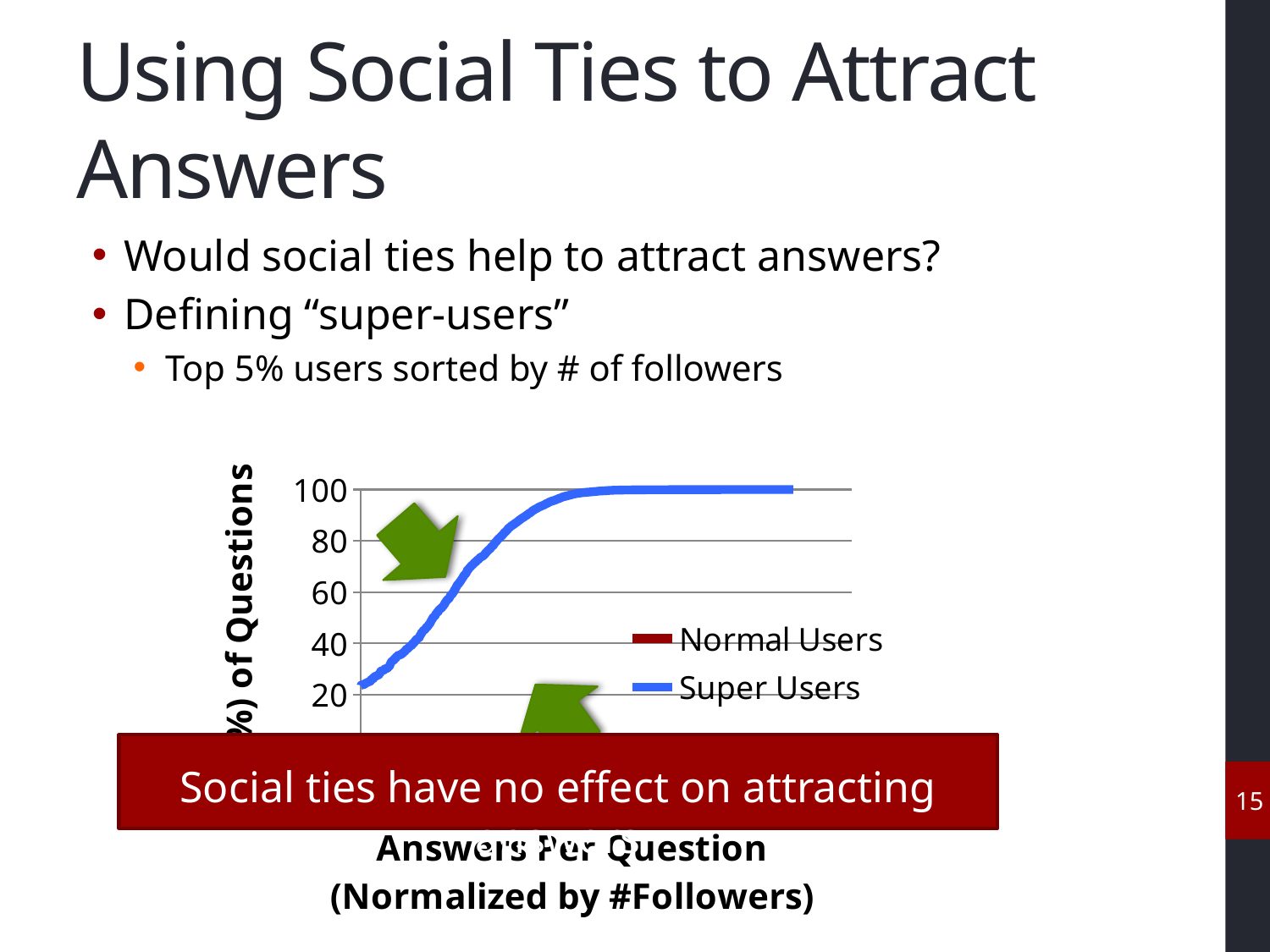
At the far right of the chart, is the Super Users line greater or less than 80? greater What is the highest tick value shown on the chart's y axis? 100 What kind of chart is shown on the slide? line chart At the far left of the chart, is the Super Users line greater or less than 40? less What is the x-axis label of the chart? Answers Per Question (Normalized by #Followers) Does the Super Users line rise or fall as you move from left to right along the x axis? rise How many series does the chart's legend list? 2 What are the two series named in the chart's legend? Normal Users and Super Users What colour is the Super Users line in the chart? blue What is the lowest tick value printed on the chart's y axis? 20